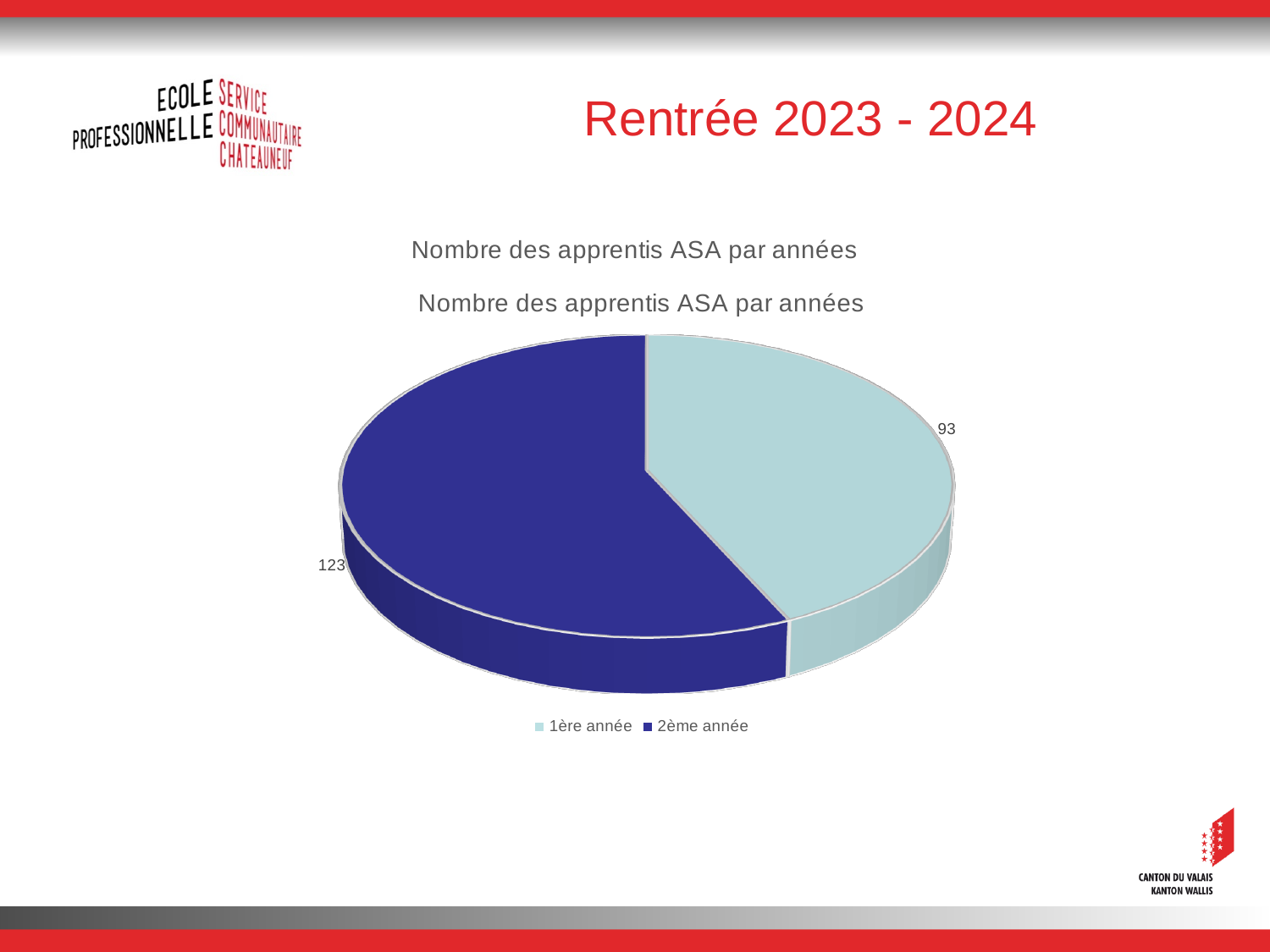
What is the difference between the values for 2ème année and 1ère année? 30 How many entries does the legend list? 2 Which colour represents 2ème année in the legend? dark blue What is the title of the chart? Nombre des apprentis ASA par années How many slices does the pie chart have? 2 Which is larger, the value for 1ère année or the value for 2ème année? 2ème année Which category has the largest slice? 2ème année What is the total of all slices in the pie chart? 216 What is the value for 1ère année? 93 What is the value for 2ème année? 123 Which category has the smallest slice? 1ère année What type of chart is shown on the slide? pie chart